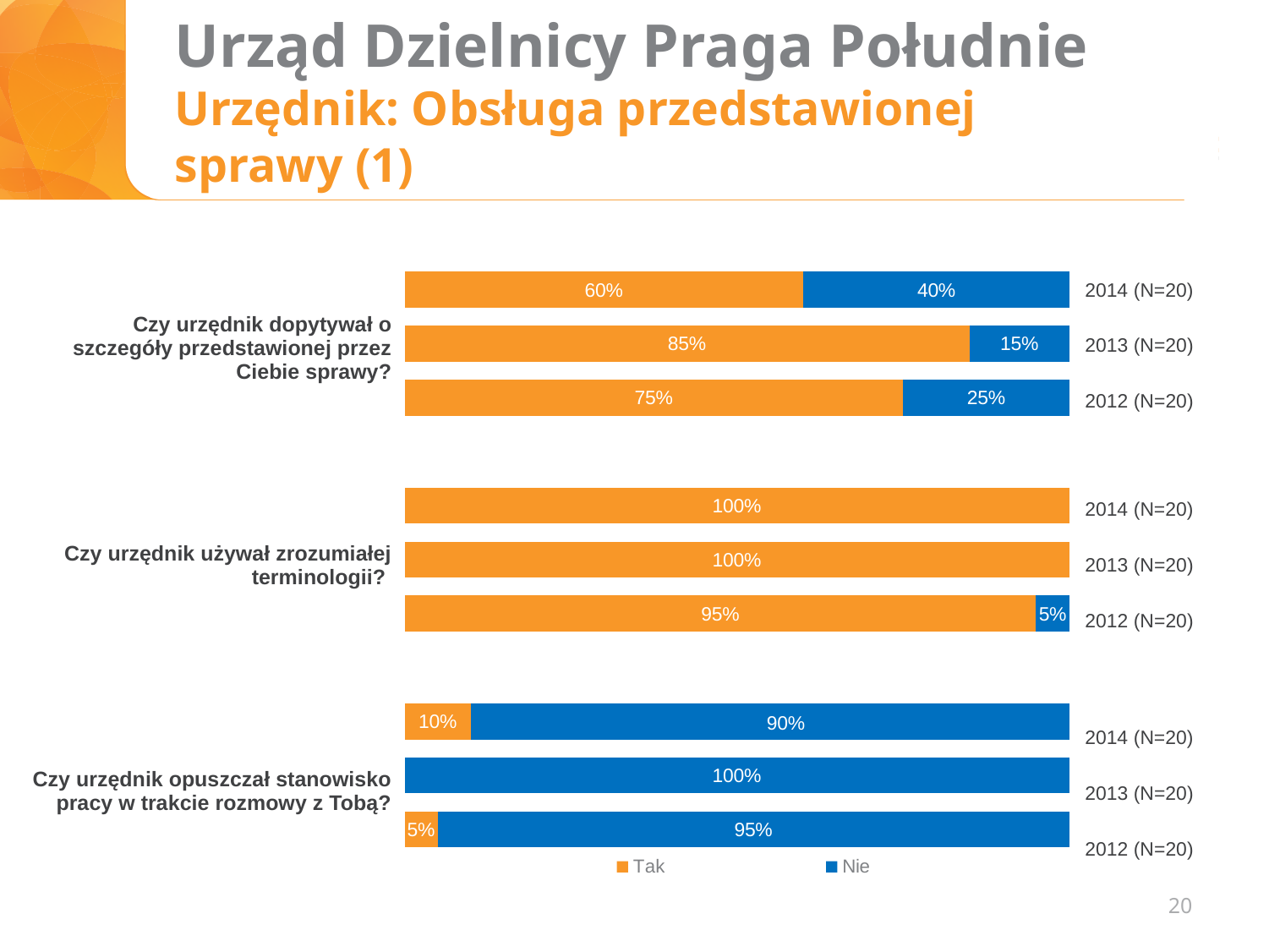
In the chart for "Czy urzędnik używał zrozumiałej terminologii?", what is the "Tak" value for 2012 (N=20)? 95% How many series does the legend list? 2 In the chart for "Czy urzędnik dopytywał o szczegóły przedstawionej przez Ciebie sprawy?", what is the difference between the "Tak" values for 2013 and 2014? 25% In the chart for "Czy urzędnik dopytywał o szczegóły przedstawionej przez Ciebie sprawy?", what is the "Tak" value for 2014 (N=20)? 60% In the chart for "Czy urzędnik dopytywał o szczegóły przedstawionej przez Ciebie sprawy?", what is the "Nie" value for 2013 (N=20)? 15% What kind of chart is shown on the slide? Stacked bar chart In the chart for "Czy urzędnik dopytywał o szczegóły przedstawionej przez Ciebie sprawy?", which year has the highest "Tak" value? 2013 (N=20) In the chart for "Czy urzędnik opuszczał stanowisko pracy w trakcie rozmowy z Tobą?", is the "Nie" value for 2012 larger or smaller than the "Nie" value for 2014? larger In the chart for "Czy urzędnik używał zrozumiałej terminologii?", which year has the lowest "Tak" value? 2012 (N=20) Which colour represents "Nie" in the legend? Blue In the chart for "Czy urzędnik opuszczał stanowisko pracy w trakcie rozmowy z Tobą?", which year has the highest "Tak" value? 2014 (N=20) In the chart for "Czy urzędnik opuszczał stanowisko pracy w trakcie rozmowy z Tobą?", what is the "Nie" value for 2014 (N=20)? 90%